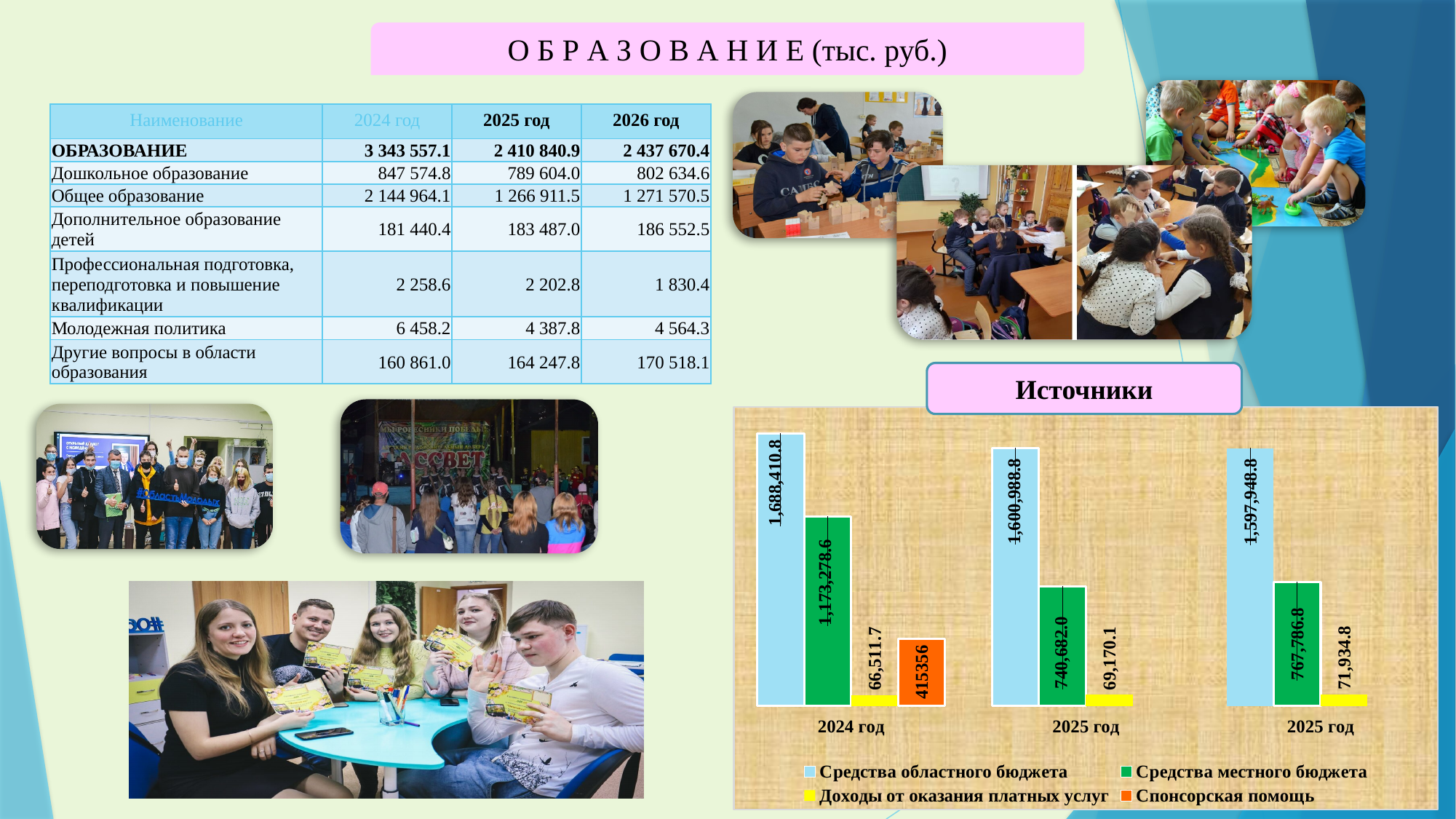
In the "Источники" chart, what is the value of "Средства местного бюджета" in the second (middle) group? 740,682.0 In the "Источники" chart, which is larger: "Средства местного бюджета" in the first group or in the second group? first group (1,173,278.6) In the "Источники" chart, what is the difference between "Средства областного бюджета" and "Средства местного бюджета" in the first group (2024 год)? 515,132.2 In the "Источники" chart, what is the value of "Спонсорская помощь" in the first group (2024 год)? 415356 In the "Источники" chart, do the values for "Средства областного бюджета" rise or fall from the first group to the third group? fall In the "Источники" chart, what is the value of "Средства областного бюджета" in the first group (2024 год)? 1,688,410.8 In the "Источники" chart, how many series does the legend list? 4 What kind of chart is shown under the title "Источники"? bar chart In the "Источники" chart, which bar is the tallest overall? Средства областного бюджета, 2024 год (1,688,410.8) In the "Источники" chart, how many year groups are shown on the x axis? 3 In the "Источники" chart, what is the value of "Доходы от оказания платных услуг" in the third (rightmost) group? 71,934.8 In the "Источники" chart, what is the value of "Средства местного бюджета" in the first group (2024 год)? 1,173,278.6